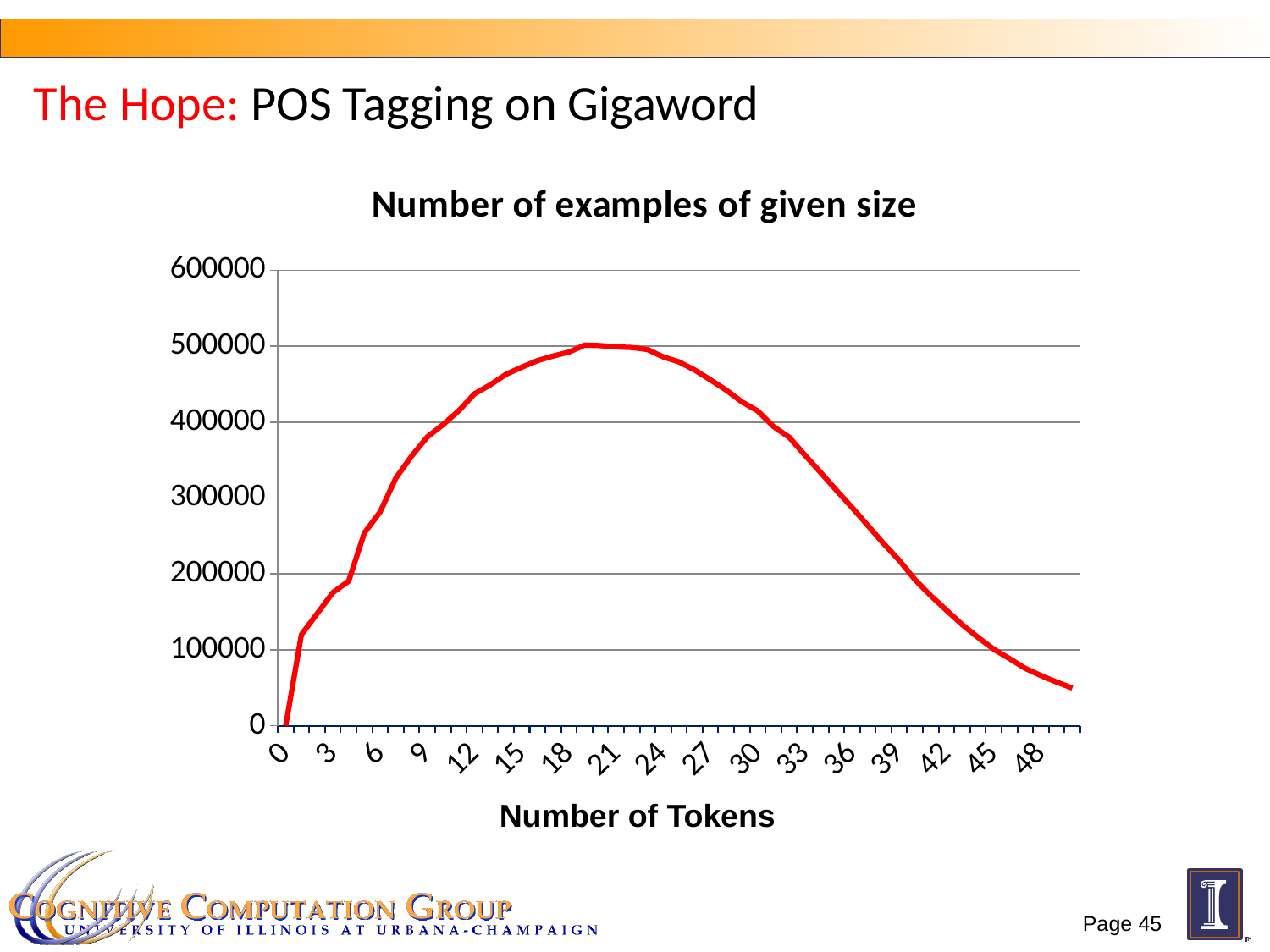
Do the values rise or fall along the x axis from 0 tokens to 18 tokens? rise Is the value at 42 tokens greater or less than 200000? less Is the value at 9 tokens greater or less than 400000? less What is the title of the chart? Number of examples of given size Is the value at 33 tokens greater or less than 400000? less What is the label of the x axis? Number of Tokens What kind of chart is shown on the slide? line chart Do the values rise or fall along the x axis from 24 tokens to 48 tokens? fall Which has the larger value, 12 tokens or 42 tokens? 12 tokens